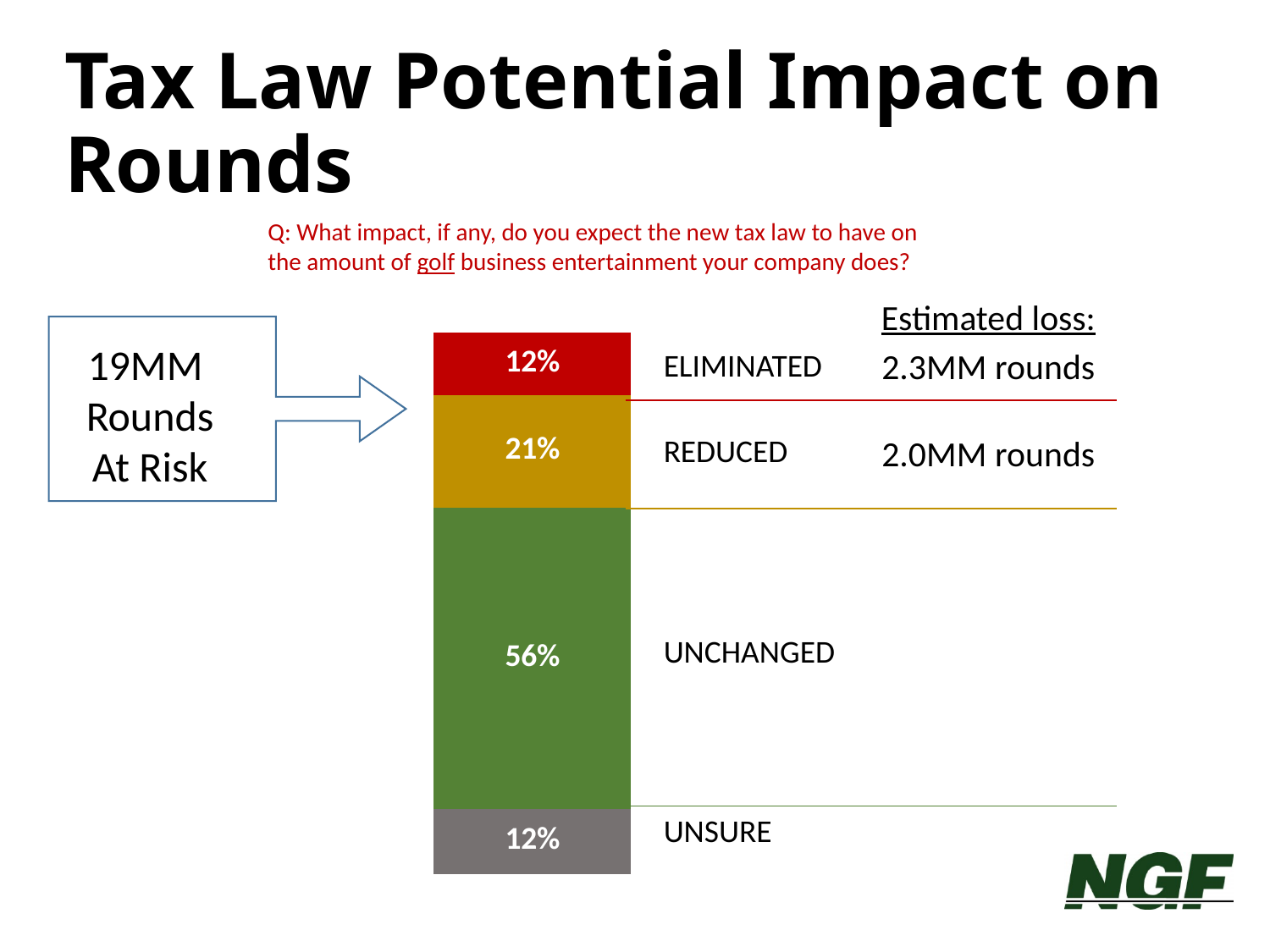
What is the difference in percentage points between the UNCHANGED and REDUCED segments? 35 Which response category has the largest share of the stacked bar? UNCHANGED What is the estimated loss in rounds associated with the ELIMINATED segment? 2.3MM rounds What percentage of respondents expect golf business entertainment to be UNCHANGED? 56% What is the combined percentage of respondents expecting golf entertainment to be ELIMINATED or REDUCED? 33% What percentage of respondents are UNSURE? 12% What percentage of respondents expect golf business entertainment to be ELIMINATED? 12% Which segment is larger, REDUCED or ELIMINATED? REDUCED What percentage of respondents expect golf business entertainment to be REDUCED? 21% How many segments make up the stacked bar? 4 What kind of chart is shown on the slide? Stacked bar chart What colour is the UNCHANGED segment of the bar? Green